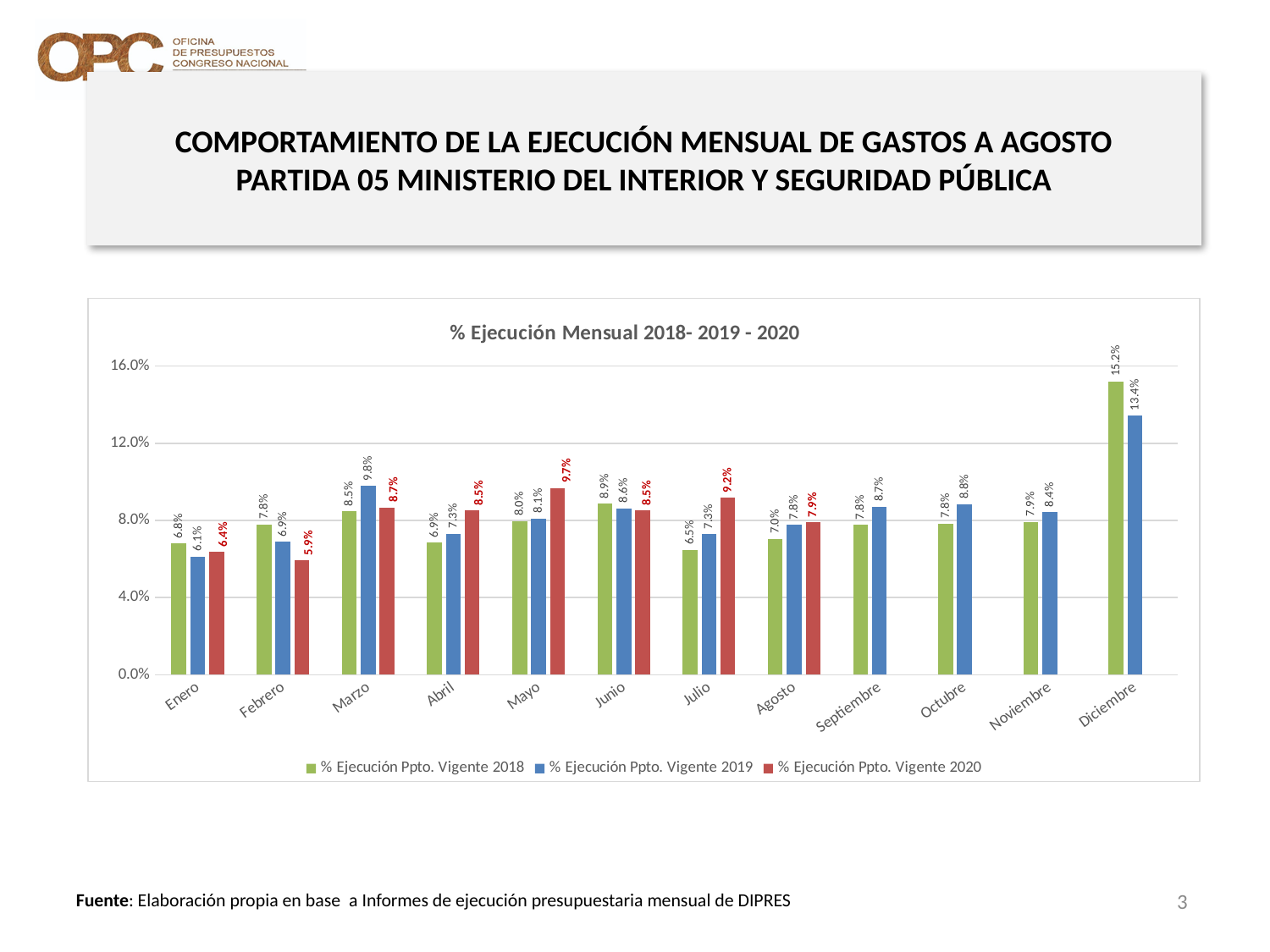
What kind of chart is shown? Bar chart Is the value for % Ejecución Ppto. Vigente 2018 in Diciembre greater or less than 12.0%? greater Which month has the highest value for % Ejecución Ppto. Vigente 2018? Diciembre What is the value for % Ejecución Ppto. Vigente 2018 in Junio? 8.9% What is the title of the chart? % Ejecución Mensual 2018- 2019 - 2020 What is the value for % Ejecución Ppto. Vigente 2020 in Mayo? 9.7% How many months are shown on the x axis? 12 How many series does the legend list? 3 What is the value for % Ejecución Ppto. Vigente 2019 in Diciembre? 13.4% In Julio, which is larger: the 2019 value or the 2020 value? 2020 (9.2%) What is the difference between the 2018 and 2019 values in Diciembre? 1.8% Which month has the lowest value for % Ejecución Ppto. Vigente 2020? Febrero